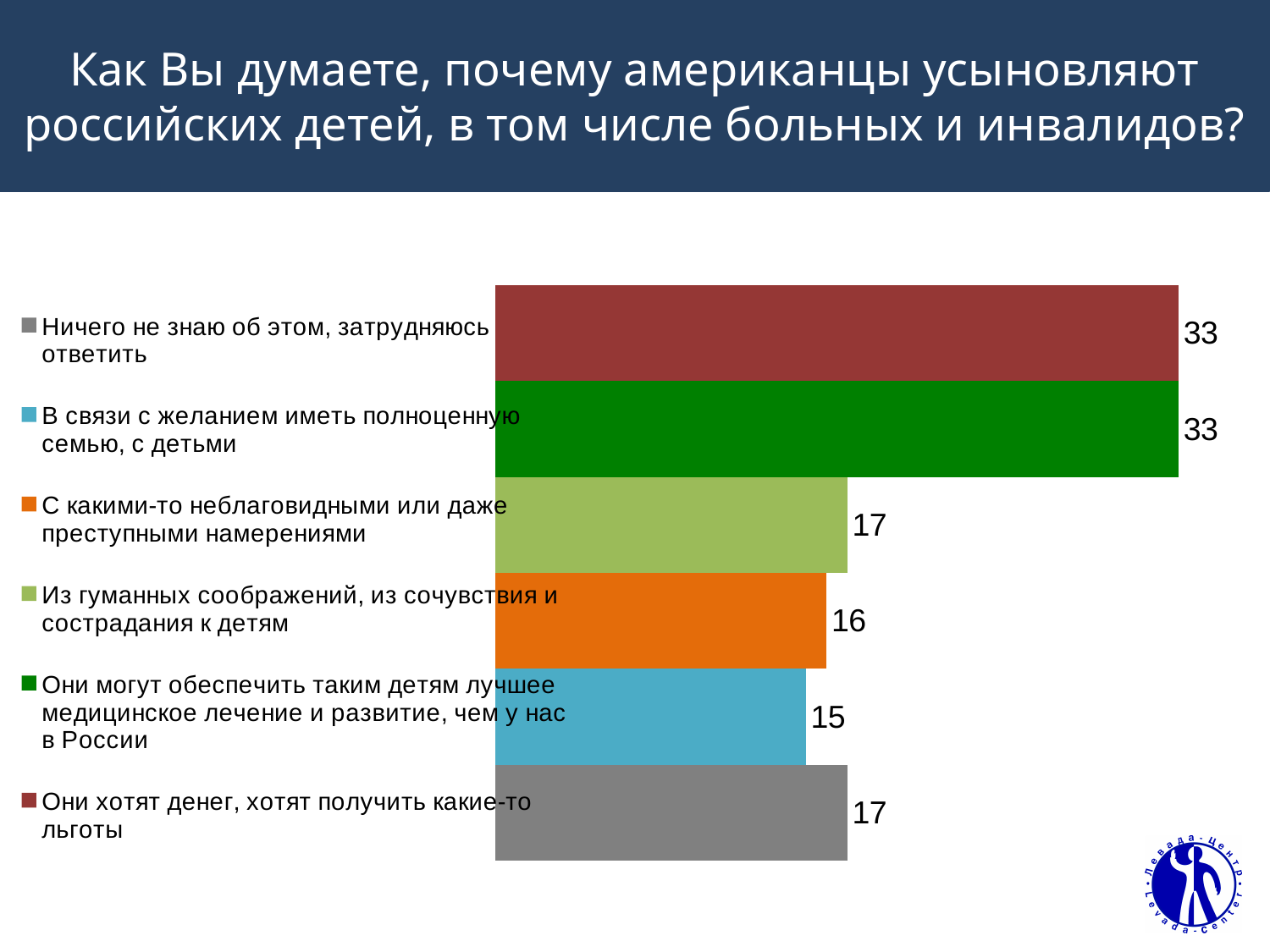
How many bars does the chart have? 6 What is the value for "В связи с желанием иметь полноценную семью, с детьми"? 15 What is the value for "Из гуманных соображений, из сочувствия и сострадания к детям"? 17 What is the value for "Ничего не знаю об этом, затрудняюсь ответить"? 17 What is the value for "Они могут обеспечить таким детям лучшее медицинское лечение и развитие, чем у нас в России"? 33 How many entries does the legend list? 6 Which category has the lowest value? В связи с желанием иметь полноценную семью, с детьми What is the difference between the value for "Они хотят денег, хотят получить какие-то льготы" and the value for "Из гуманных соображений, из сочувствия и сострадания к детям"? 16 Which is larger: the value for "С какими-то неблаговидными или даже преступными намерениями" or the value for "Ничего не знаю об этом, затрудняюсь ответить"? Ничего не знаю об этом, затрудняюсь ответить What is the value for "С какими-то неблаговидными или даже преступными намерениями"? 16 What is the value for "Они хотят денег, хотят получить какие-то льготы"? 33 What kind of chart is shown on the slide? bar chart